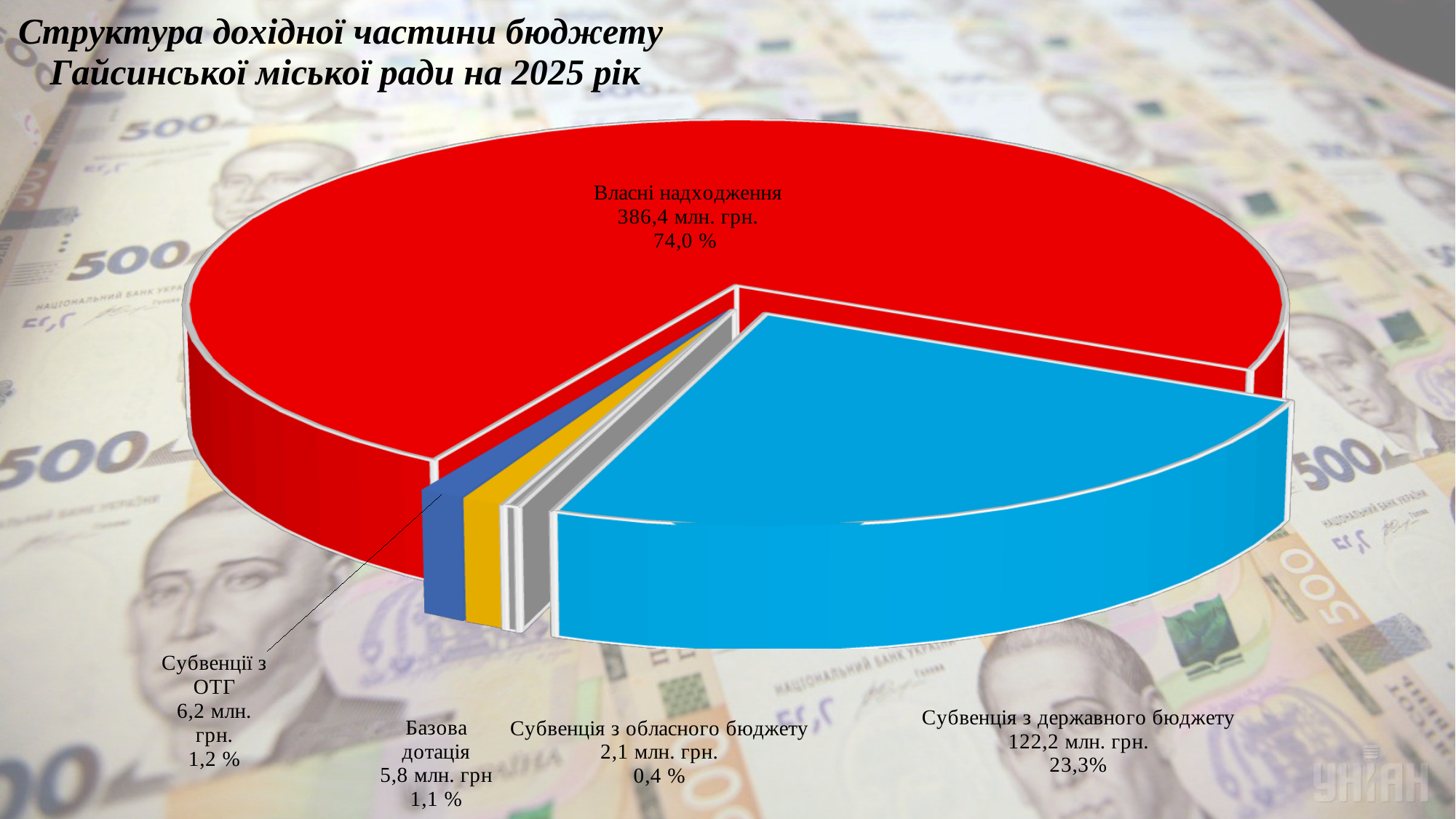
Which category has the largest slice? Власні надходження Which category has the smallest slice? Субвенція з обласного бюджету What is the value for Базова дотація? 5,8 млн. грн What share of the pie does Субвенція з державного бюджету represent? 23,3% What is the value for Власні надходження? 386,4 млн. грн. Which colour is the slice for Субвенція з державного бюджету? blue What is the difference between Власні надходження and Субвенція з державного бюджету in млн. грн.? 264,2 млн. грн. How many slices does the pie chart have? 5 What is the value for Субвенція з державного бюджету? 122,2 млн. грн. What share of the pie does Субвенції з ОТГ represent? 1,2 % What is the value for Субвенція з обласного бюджету? 2,1 млн. грн. What kind of chart is shown on the slide? pie chart